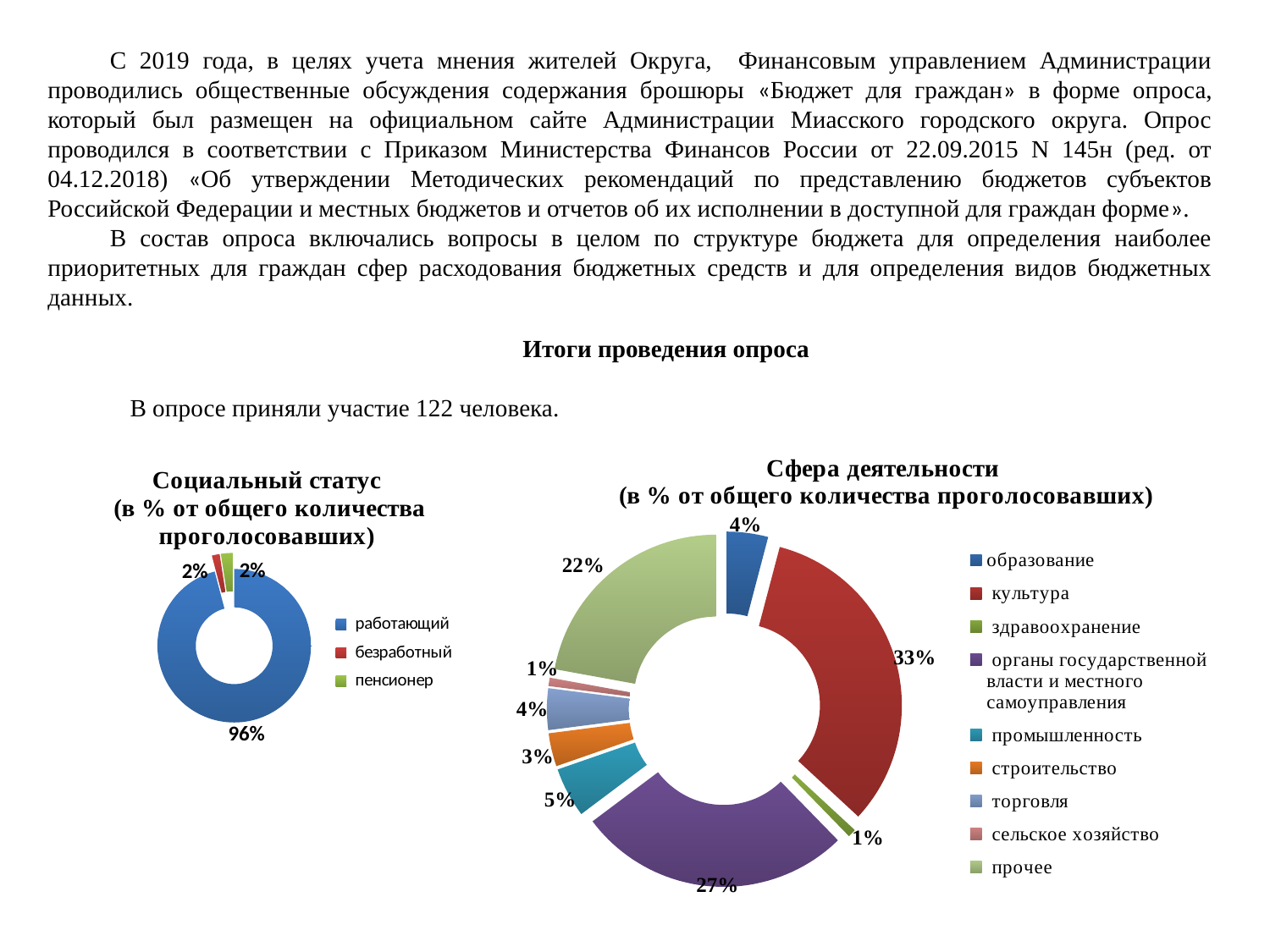
In the chart titled «Социальный статус», which category has the largest share? работающий In the chart titled «Сфера деятельности», what percentage corresponds to «прочее»? 22% In the chart titled «Сфера деятельности», how many categories does the legend list? 9 In the chart titled «Сфера деятельности», what percentage corresponds to «промышленность»? 5% In the chart titled «Сфера деятельности», what percentage corresponds to «культура»? 33% In the chart titled «Сфера деятельности», which category has the largest share? культура In the chart titled «Социальный статус», what percentage of respondents are «пенсионер»? 2% In the chart titled «Сфера деятельности», which is larger: «торговля» or «строительство»? торговля In the chart titled «Сфера деятельности», what is the difference between the shares of «культура» and «прочее»? 11% In the chart titled «Социальный статус», how many categories does the legend list? 3 In the chart titled «Сфера деятельности», what percentage corresponds to «органы государственной власти и местного самоуправления»? 27% In the chart titled «Социальный статус», what percentage of respondents are «работающий»? 96%